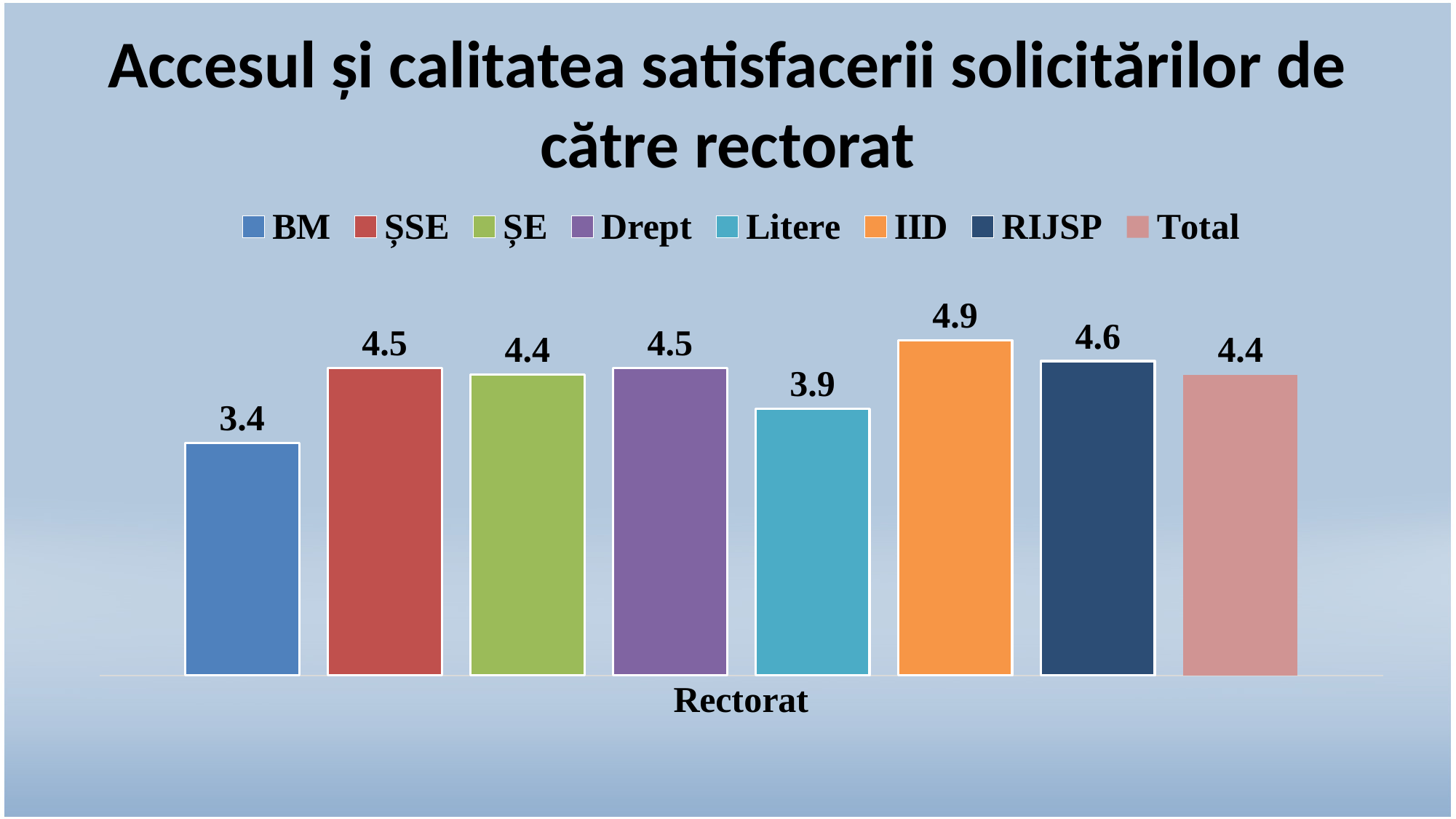
What is the difference between the values for IID and BM? 1.5 Which is larger, the value for ȘSE or the value for Litere? ȘSE What is the value for RIJSP? 4.6 What is the value for Litere? 3.9 Which series has the lowest value? BM Which series has the highest value? IID What is the value for IID? 4.9 How many series does the legend list? 8 What kind of chart is shown on the slide? Bar chart What is the difference between the values for RIJSP and Litere? 0.7 What is the label shown on the x axis below the bars? Rectorat What is the value for BM? 3.4